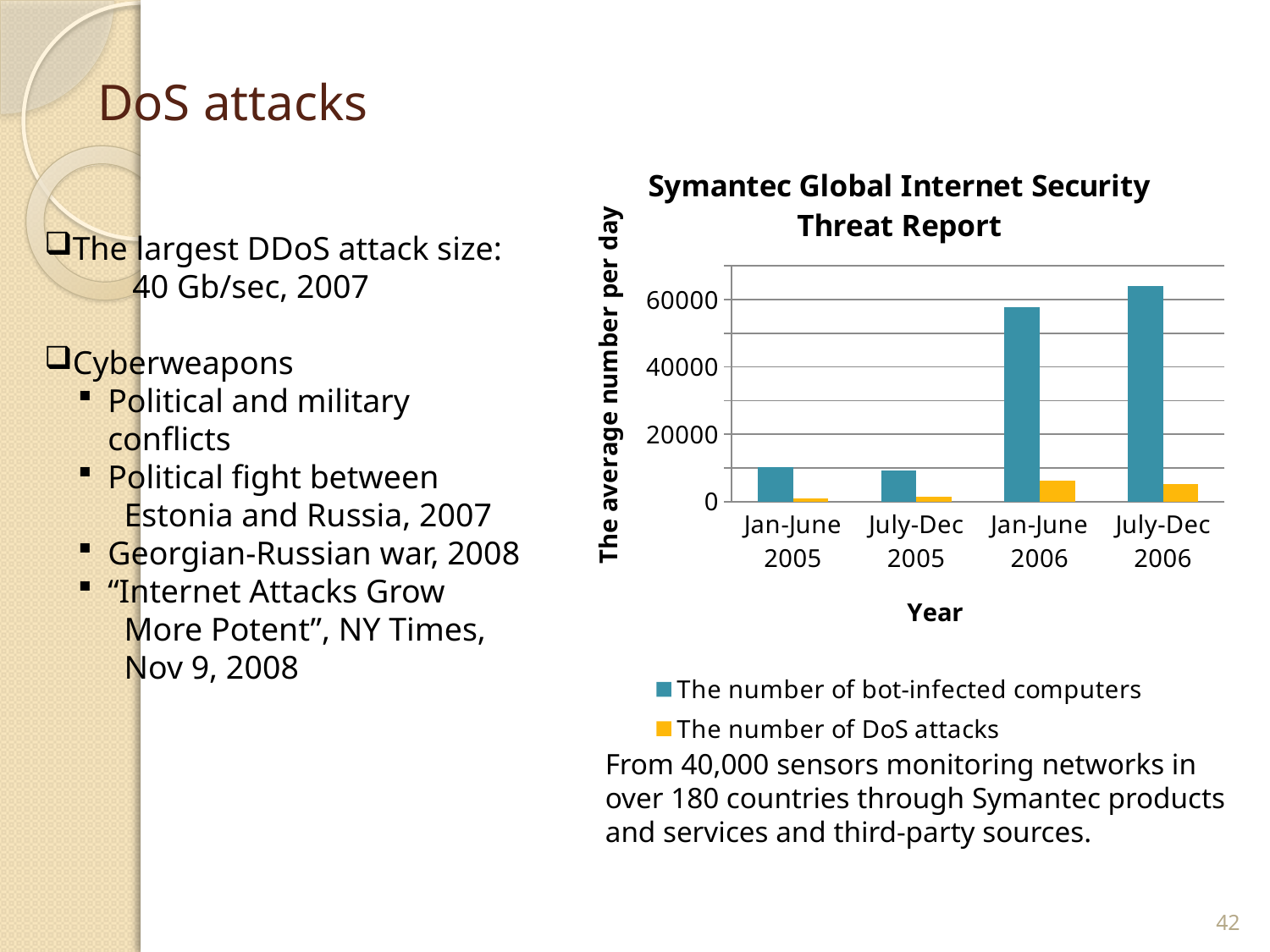
What is the label of the y axis of the chart? The average number per day How many series does the legend of the chart list? 2 Is the number of bot-infected computers for July-Dec 2006 greater or less than 60000? greater Is the number of bot-infected computers for Jan-June 2006 greater or less than 40000? greater Is the number of bot-infected computers for Jan-June 2005 greater or less than 20000? less How many time periods are shown on the x axis of the chart? 4 In Jan-June 2006, which is larger: the number of bot-infected computers or the number of DoS attacks? The number of bot-infected computers What is the title of the chart? Symantec Global Internet Security Threat Report What kind of chart is shown on the slide? bar chart In which period is the number of bot-infected computers highest? July-Dec 2006 Which is larger: the number of bot-infected computers in July-Dec 2005 or in July-Dec 2006? July-Dec 2006